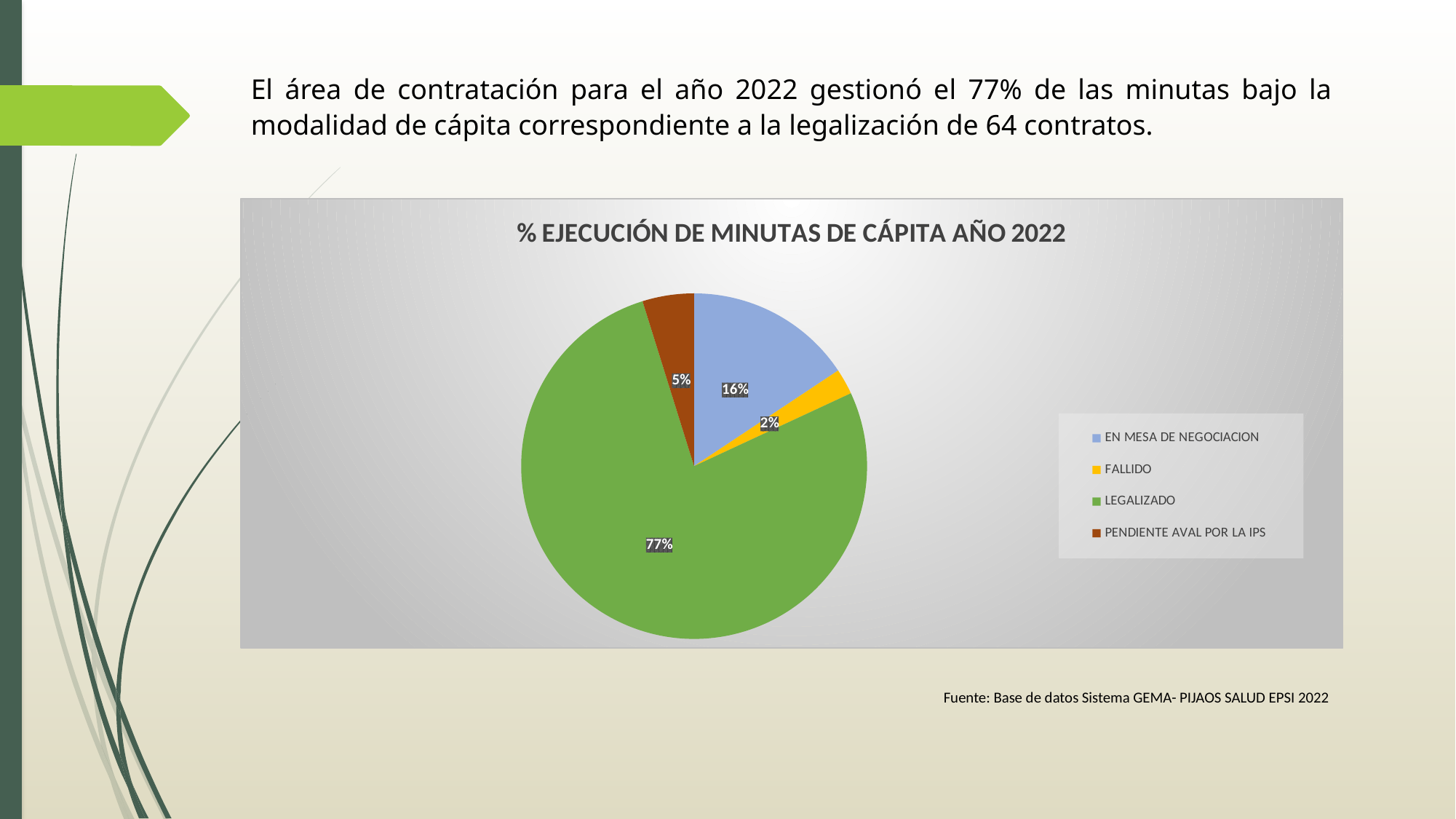
What share of the pie does PENDIENTE AVAL POR LA IPS represent? 5% How many categories does the legend list? 4 What share of the pie does EN MESA DE NEGOCIACION represent? 16% What is the difference between the LEGALIZADO share and the EN MESA DE NEGOCIACION share? 61% What colour is the LEGALIZADO slice? Green What type of chart is shown on the slide? Pie chart What share of the pie does LEGALIZADO represent? 77% Which category has the largest slice of the pie? LEGALIZADO What is the title of the chart? % EJECUCIÓN DE MINUTAS DE CÁPITA AÑO 2022 Which category has the smallest slice of the pie? FALLIDO Which is larger, the share for PENDIENTE AVAL POR LA IPS or the share for FALLIDO? PENDIENTE AVAL POR LA IPS